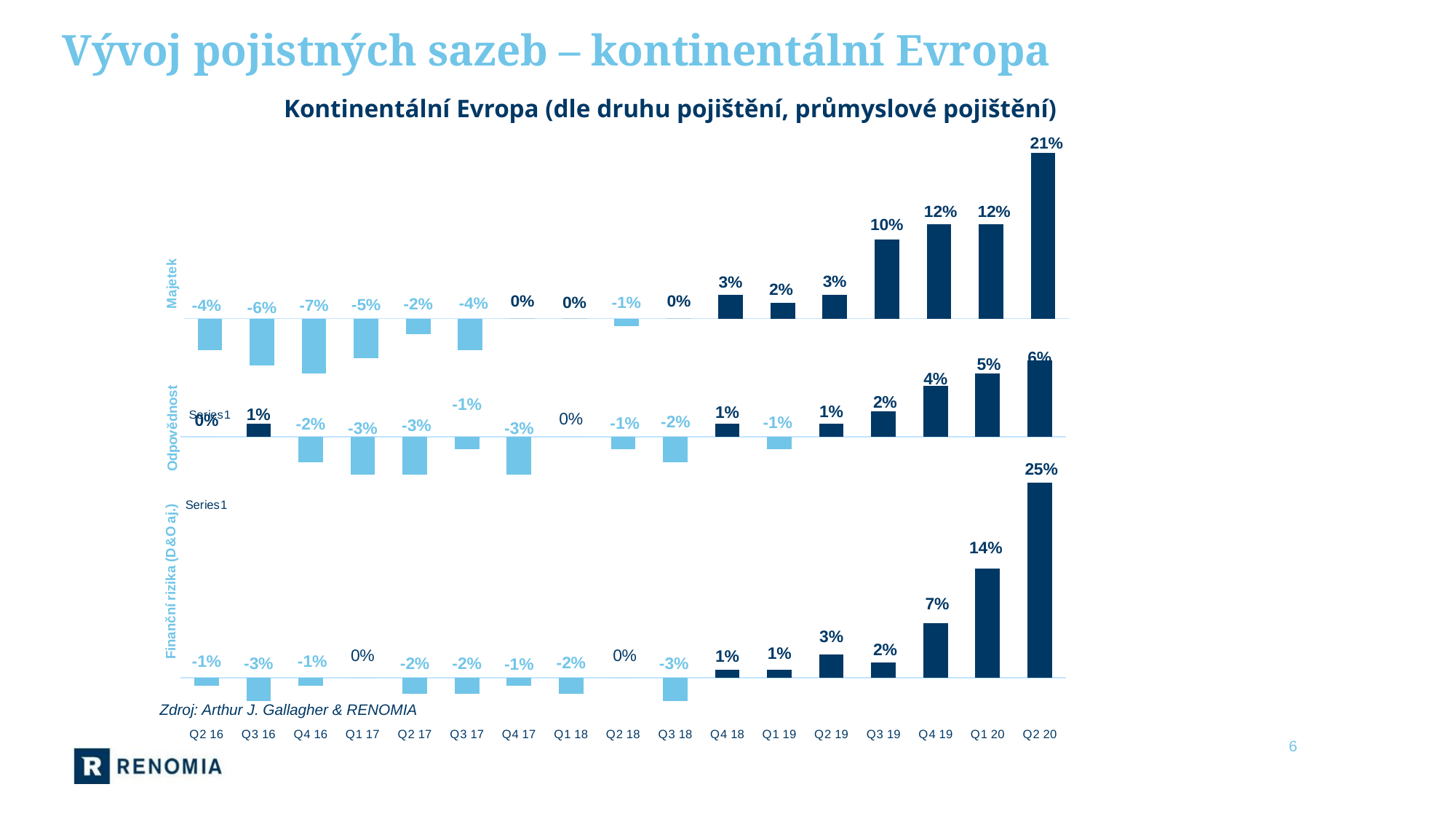
In the Finanční rizika (D&O aj.) chart, what is the difference between the values for Q2 20 and Q4 19? 18% In the Majetek chart, which quarter has the lowest value? Q4 16 In the Finanční rizika (D&O aj.) chart, what is the value for Q1 20? 14% In the Odpovědnost chart, which is larger, the value for Q1 20 or the value for Q3 19? Q1 20 In the Majetek chart, what is the difference between the values for Q2 20 and Q1 20? 9% What kind of chart is used for the Majetek data? Bar chart How many quarters are shown on the x axis of the charts? 17 In the Odpovědnost chart, what is the value for Q4 19? 4% In the Majetek chart, what is the value for Q2 20? 21% In the Majetek chart, what is the value for Q4 16? -7% In the Finanční rizika (D&O aj.) chart, do the values generally rise or fall from Q4 18 to Q2 20? Rise In the Finanční rizika (D&O aj.) chart, which quarter has the highest value? Q2 20